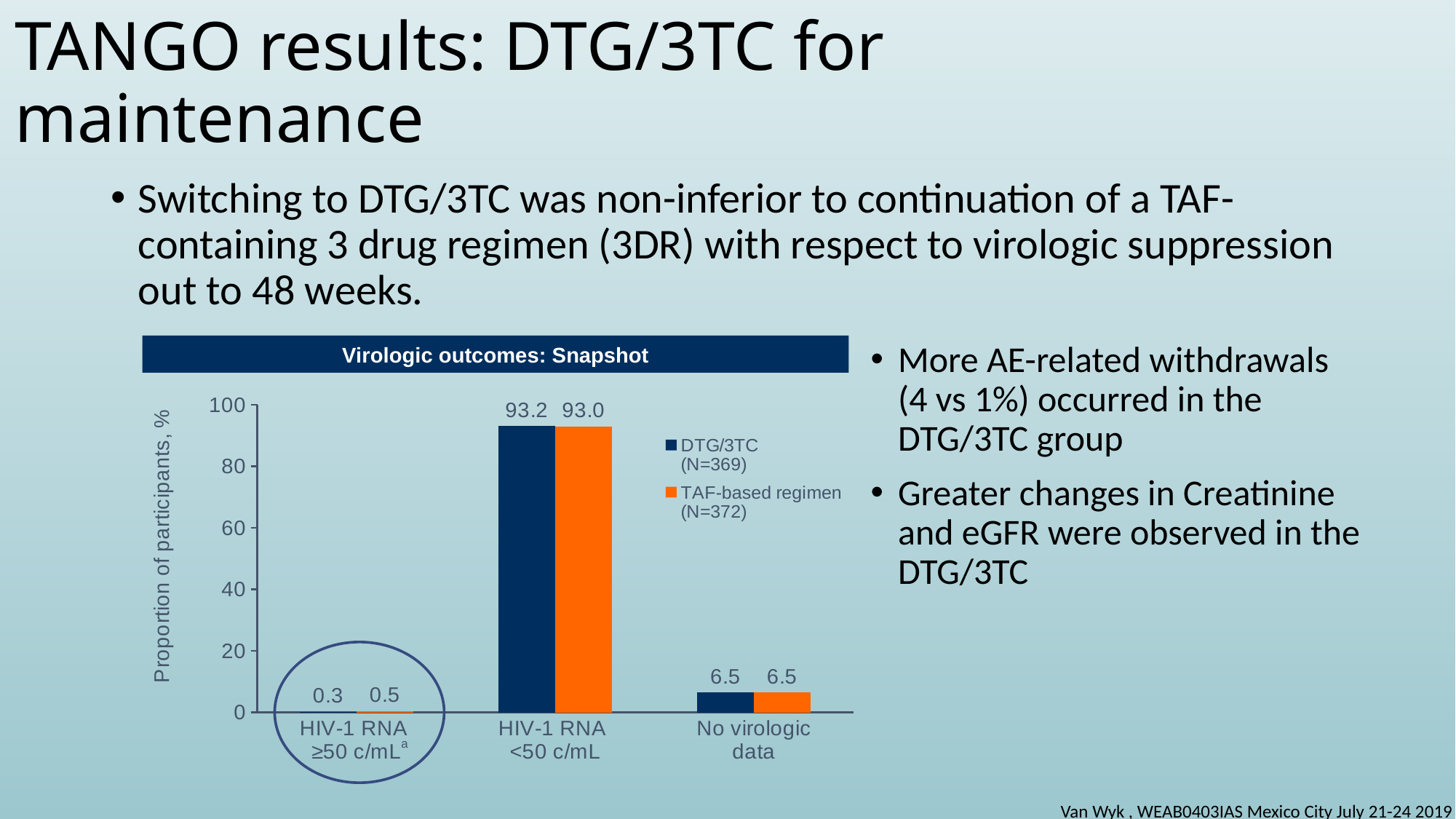
How many categories are shown on the x axis? 3 How many series does the legend list? 2 What is the difference between the DTG/3TC and TAF-based regimen values in the HIV-1 RNA <50 c/mL category? 0.2 Which category has the highest value for DTG/3TC? HIV-1 RNA <50 c/mL What is the value for the TAF-based regimen in the HIV-1 RNA <50 c/mL category? 93.0 What is the value for DTG/3TC in the HIV-1 RNA <50 c/mL category? 93.2 What kind of chart is shown on the slide? Bar chart What is the value for DTG/3TC in the No virologic data category? 6.5 What is the value for the TAF-based regimen in the HIV-1 RNA ≥50 c/mL category? 0.5 What is the title of the chart? Virologic outcomes: Snapshot What is the value for DTG/3TC in the HIV-1 RNA ≥50 c/mL category? 0.3 Which category has the lowest value for the TAF-based regimen? HIV-1 RNA ≥50 c/mL